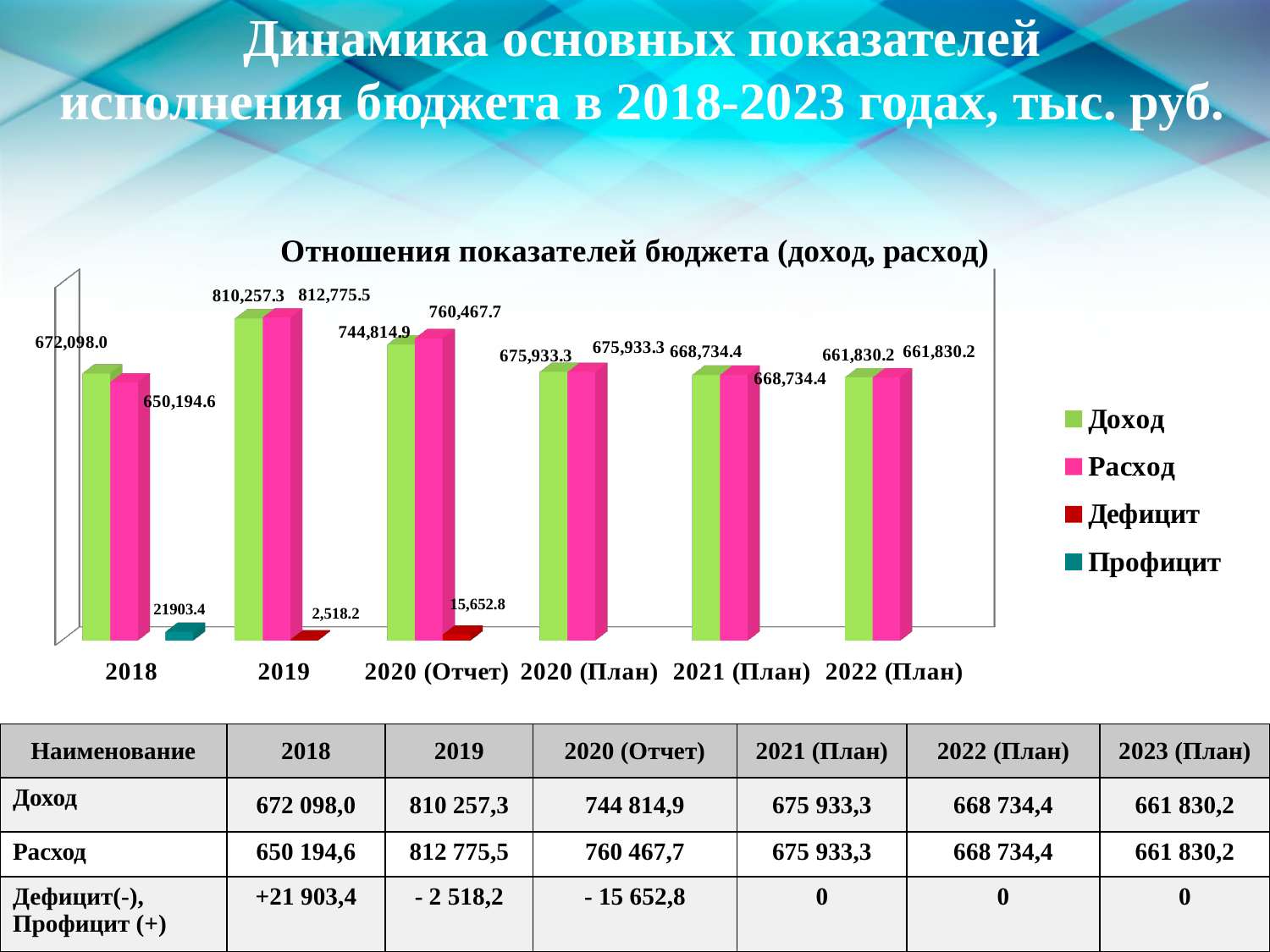
What is the value of Доход for 2019? 810,257.3 What is the value of Профицит for 2018? 21903.4 Which is larger for 2019: Доход or Расход? Расход What is the value of Расход for 2020 (Отчет)? 760,467.7 What is the value of Дефицит for 2020 (Отчет)? 15,652.8 Which category has the highest value of Доход? 2019 Which category has the lowest value of Расход? 2018 What kind of chart is shown on the slide? bar chart What is the difference between Доход for 2019 and Доход for 2018? 138,159.3 How many series does the legend list? 4 How many categories are shown on the x axis? 6 What is the difference between Доход and Расход for 2018? 21,903.4